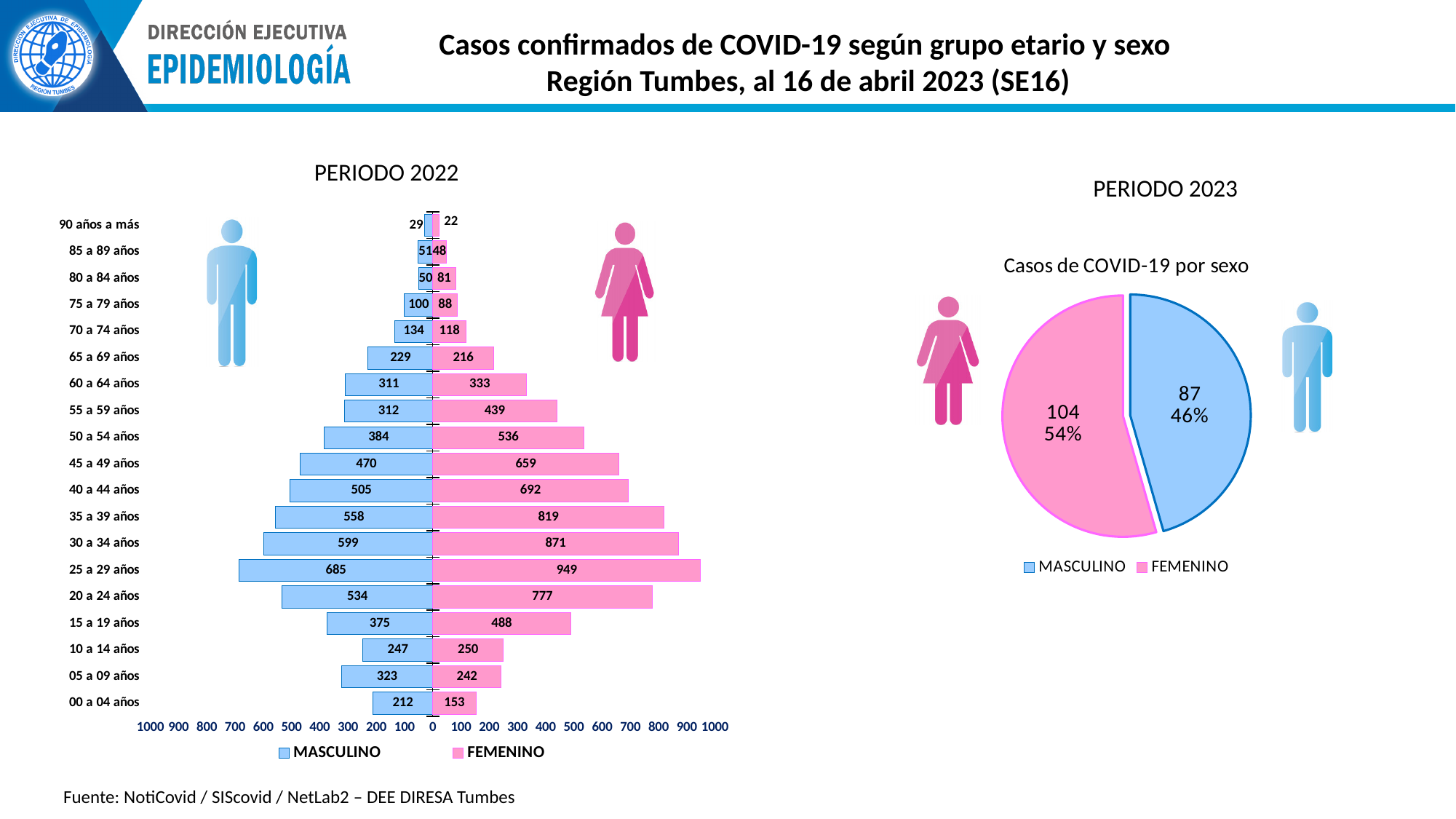
How many series does the legend of the PERIODO 2022 chart list? 2 In the PERIODO 2023 pie chart, what is the total number of cases across both sexes? 191 In the PERIODO 2022 chart, what is the FEMENINO value for the 25 a 29 años age group? 949 In the PERIODO 2022 chart, which age group has the lowest FEMENINO value? 90 años a más How many age groups are shown in the PERIODO 2022 chart? 19 In the PERIODO 2022 chart, what is the MASCULINO value for the 45 a 49 años age group? 470 In the PERIODO 2022 chart, which age group has the highest MASCULINO value? 25 a 29 años In the PERIODO 2023 pie chart, what is the number of MASCULINO cases? 87 In the PERIODO 2022 chart, what is the difference between the FEMENINO and MASCULINO values for the 30 a 34 años age group? 272 In the PERIODO 2022 chart, which is larger for the 05 a 09 años age group, MASCULINO or FEMENINO? MASCULINO In the PERIODO 2023 pie chart, what share of cases is FEMENINO? 54% What kind of chart is the PERIODO 2023 chart titled 'Casos de COVID-19 por sexo'? Pie chart